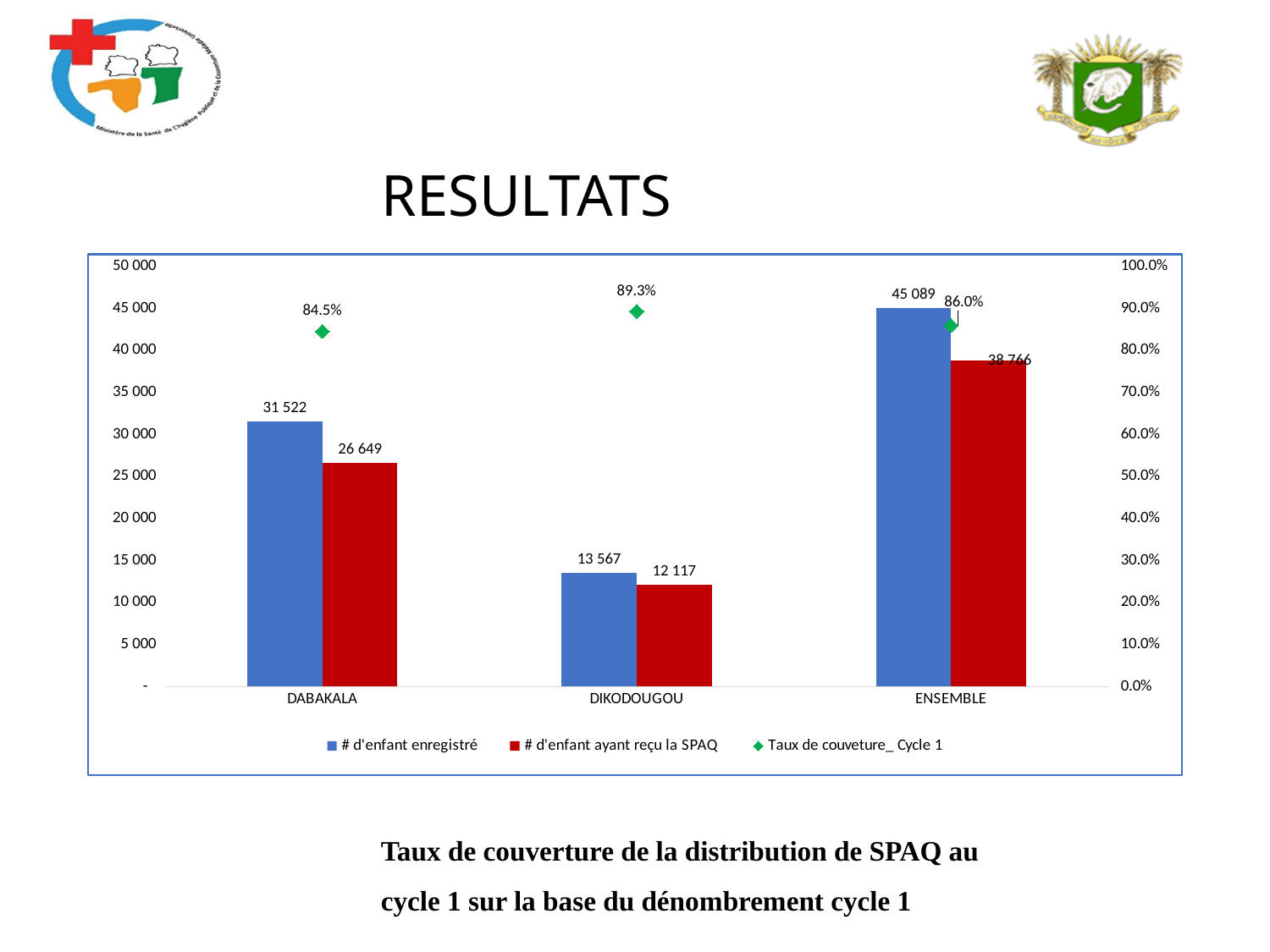
What is the value of "# d'enfant ayant reçu la SPAQ" for DIKODOUGOU? 12 117 Which is larger: "# d'enfant enregistré" for DABAKALA or for ENSEMBLE? ENSEMBLE What is the value of "# d'enfant ayant reçu la SPAQ" for ENSEMBLE? 38 766 What is the value of "# d'enfant enregistré" for DABAKALA? 31 522 What colour are the bars for "# d'enfant ayant reçu la SPAQ"? Red Which category has the highest "Taux de couveture_ Cycle 1"? DIKODOUGOU What is the difference between "# d'enfant enregistré" and "# d'enfant ayant reçu la SPAQ" for DABAKALA? 4 873 Is the value of "# d'enfant ayant reçu la SPAQ" for ENSEMBLE greater or less than 35 000? greater How many series does the chart legend list? 3 What is the "Taux de couveture_ Cycle 1" for DIKODOUGOU? 89.3% Which category has the lowest value of "# d'enfant enregistré"? DIKODOUGOU How many categories are shown on the x axis of the chart? 3